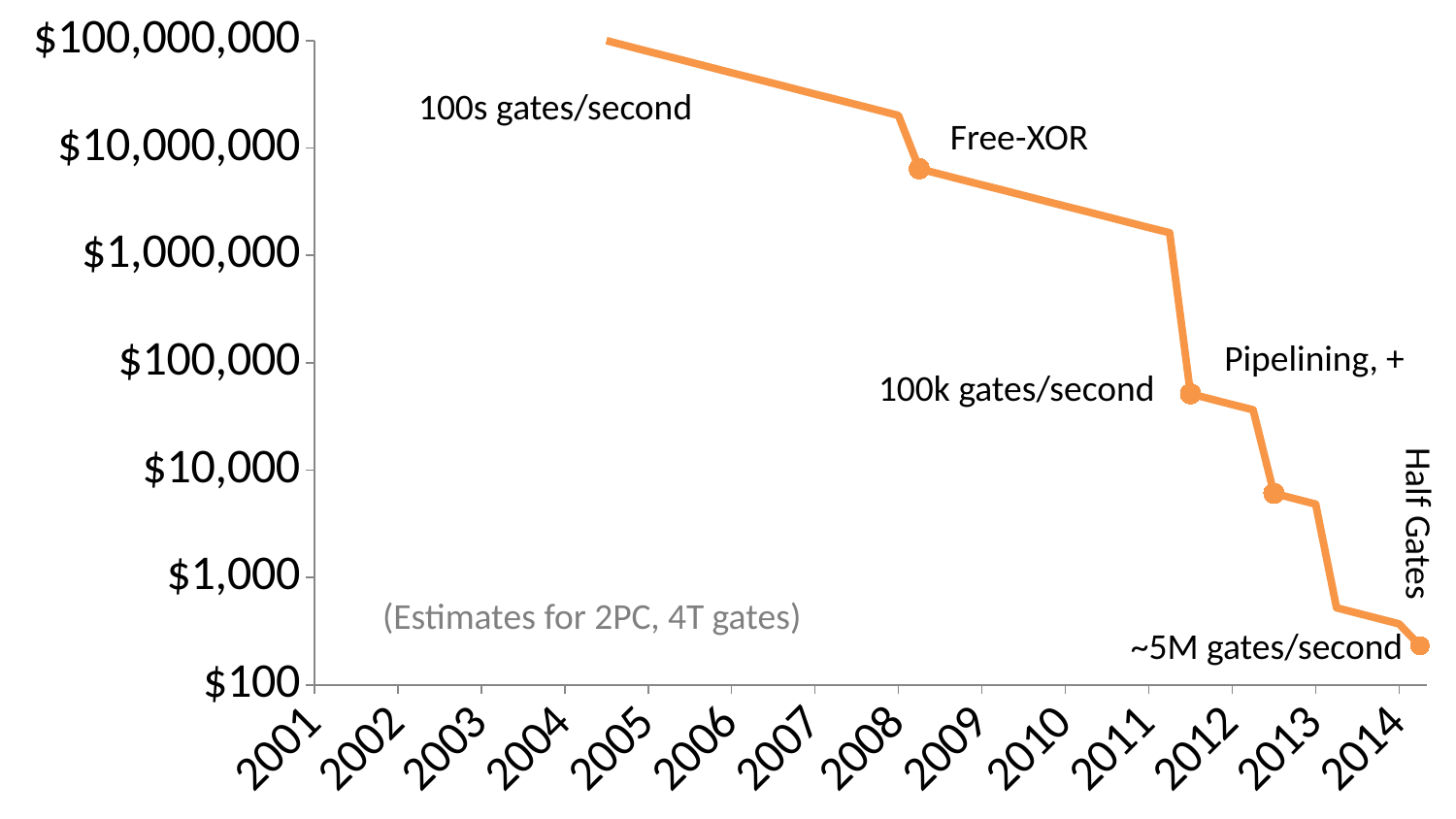
What is the highest value label shown on the y axis? $100,000,000 Is the value at the point labelled 100k gates/second greater or less than $10,000? greater How many year labels are shown on the x axis? 14 Is the value at the final point labelled ~5M gates/second greater or less than $1,000? less Is the value at the point labelled 100k gates/second greater or less than $100,000? less Do the plotted values rise or fall as the years increase along the x axis? fall How many marked data points (dots) are on the line? 4 What kind of chart is shown on the slide? line chart What note in grey text appears near the bottom of the plot area? (Estimates for 2PC, 4T gates)